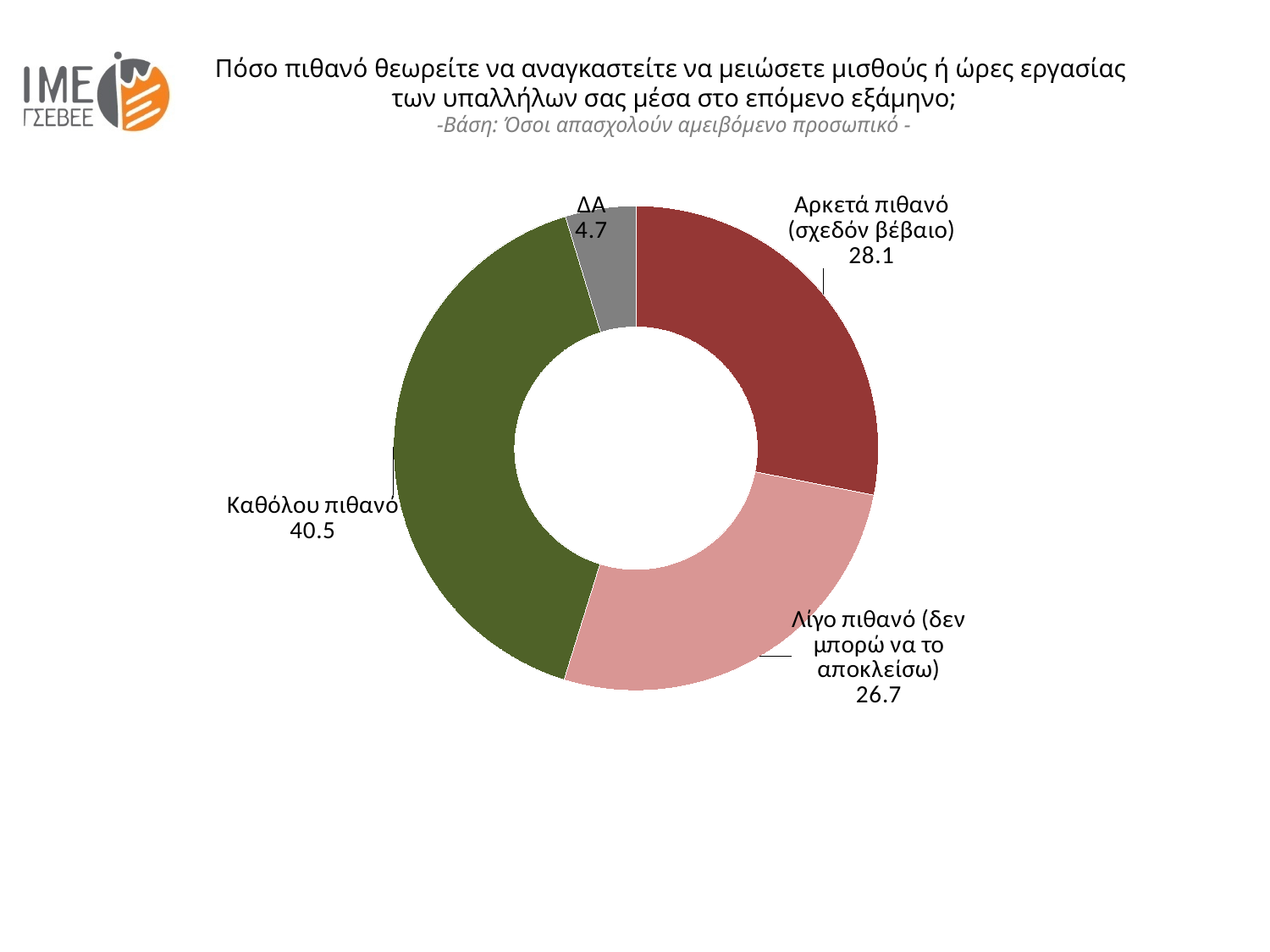
What value is shown for the 'Καθόλου πιθανό' slice? 40.5 Which category has the smallest slice? ΔΑ What colour is the 'ΔΑ' slice? grey What is the difference between the values for 'Αρκετά πιθανό (σχεδόν βέβαιο)' and 'Λίγο πιθανό (δεν μπορώ να το αποκλείσω)'? 1.4 Which category has the largest slice? Καθόλου πιθανό What kind of chart is shown on the slide? doughnut chart What is the difference between the values for 'Καθόλου πιθανό' and 'Αρκετά πιθανό (σχεδόν βέβαιο)'? 12.4 Which is larger, the value for 'Καθόλου πιθανό' or the value for 'Λίγο πιθανό (δεν μπορώ να το αποκλείσω)'? Καθόλου πιθανό What value is shown for the 'ΔΑ' slice? 4.7 What value is shown for the 'Λίγο πιθανό (δεν μπορώ να το αποκλείσω)' slice? 26.7 How many categories (slices) does the chart show? 4 What value is shown for the 'Αρκετά πιθανό (σχεδόν βέβαιο)' slice? 28.1